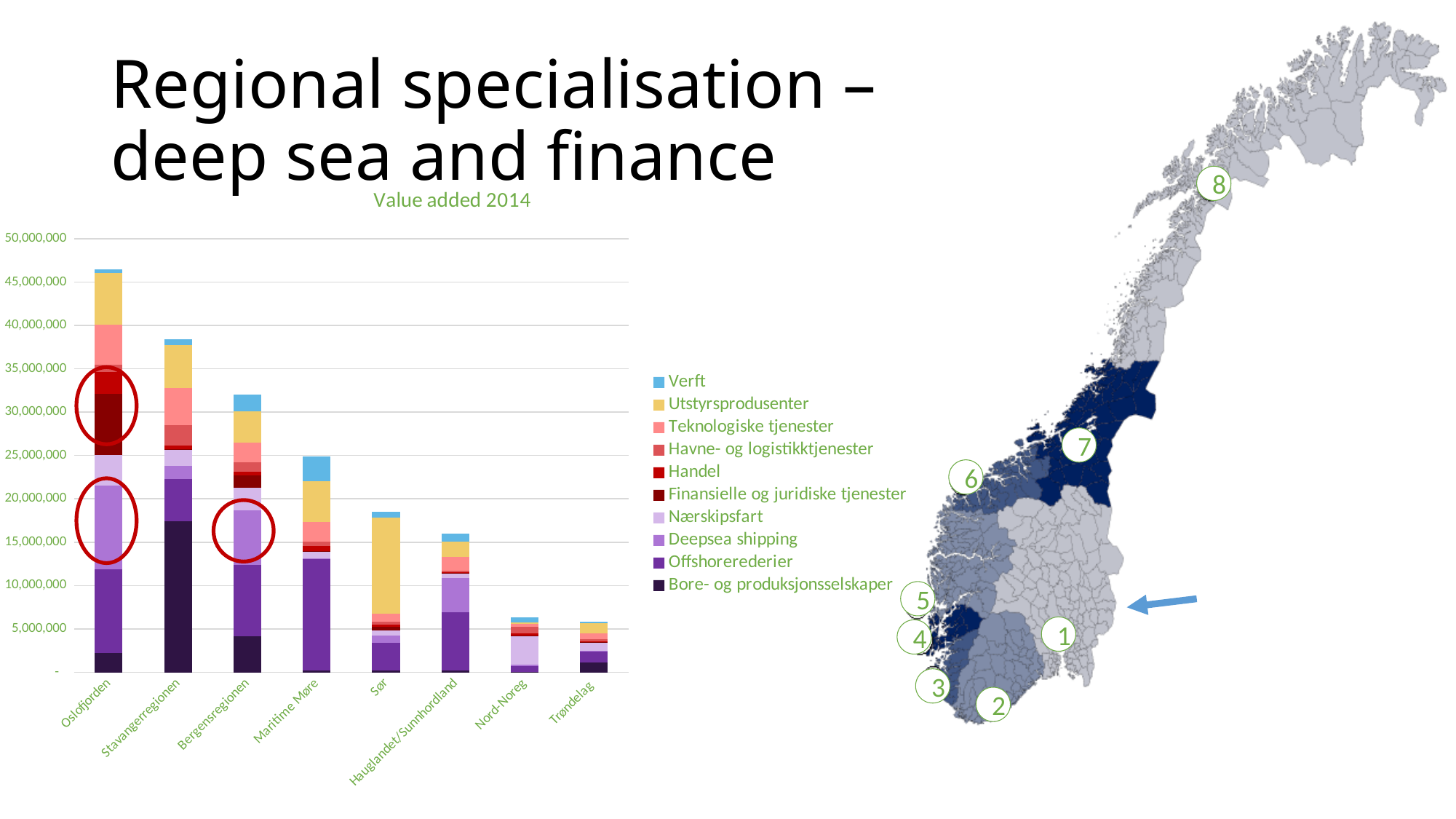
What kind of chart is shown on the slide? Stacked bar chart Is the total value for Sør greater or less than 20,000,000? less Is the total value for Stavangerregionen greater or less than 35,000,000? greater What is the title of the chart? Value added 2014 Which has the larger total value added, Stavangerregionen or Bergensregionen? Stavangerregionen Which series is listed first (at the top) in the chart's legend? Verft How many series does the chart's legend list? 10 Do the total bar heights generally rise or fall moving from left to right along the x axis? fall How many regions (categories) are shown on the x axis of the chart? 8 Is the total value for Oslofjorden greater or less than 40,000,000? greater Which region has the highest total value added in the chart? Oslofjorden